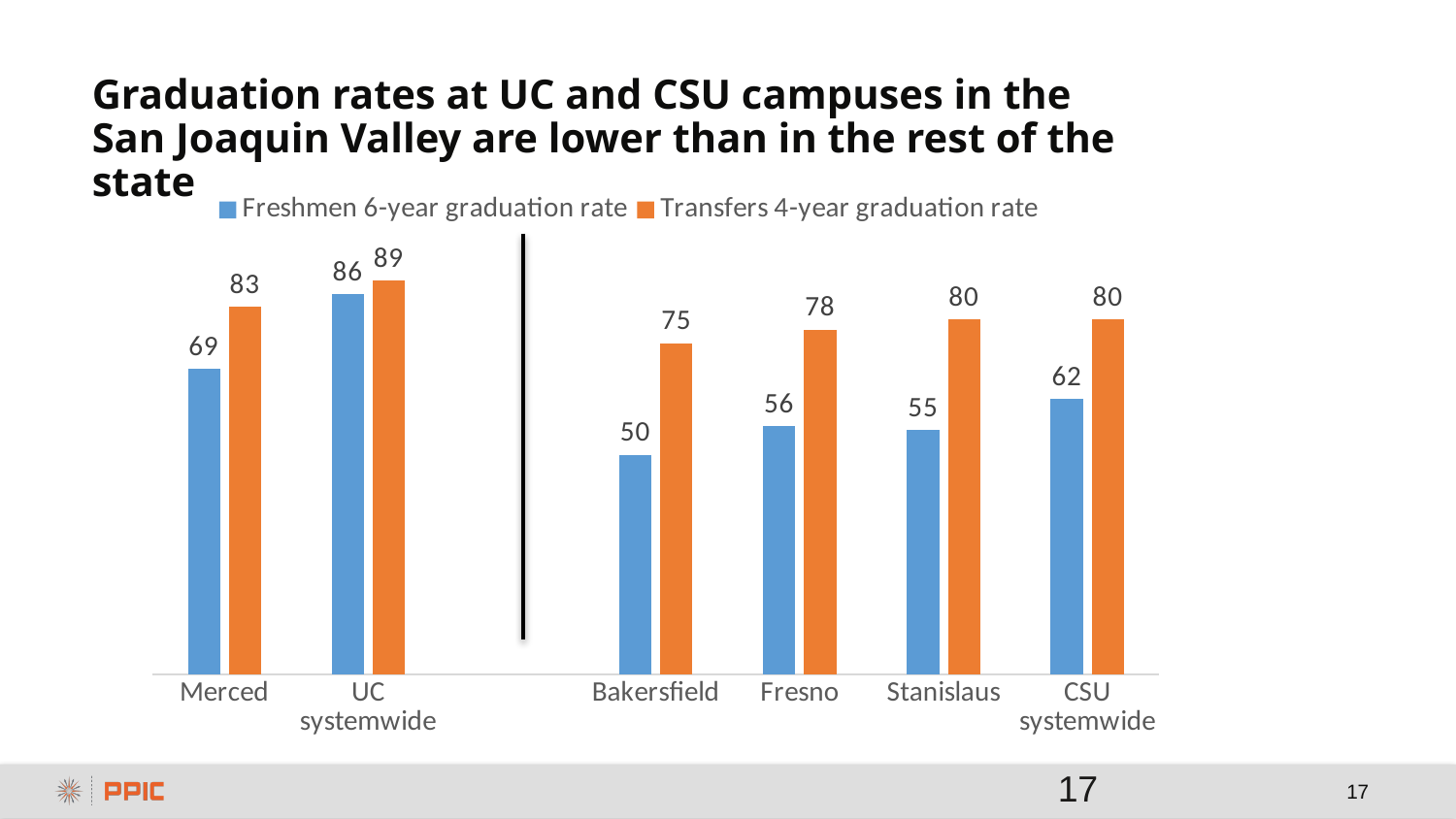
What is the Transfers 4-year graduation rate for Fresno? 78 Which is larger, the Freshmen 6-year graduation rate for CSU systemwide or for Fresno? CSU systemwide What is the Freshmen 6-year graduation rate for Merced? 69 What kind of chart is shown on the slide? Bar chart Which category has the highest Freshmen 6-year graduation rate? UC systemwide What is the Freshmen 6-year graduation rate for Bakersfield? 50 How many series does the legend list? 2 Which category has the lowest Transfers 4-year graduation rate? Bakersfield What is the difference between the Transfers 4-year graduation rate and the Freshmen 6-year graduation rate for Stanislaus? 25 How many categories are shown on the x axis? 6 Which colour represents the Transfers 4-year graduation rate series? Orange What is the Transfers 4-year graduation rate for UC systemwide? 89